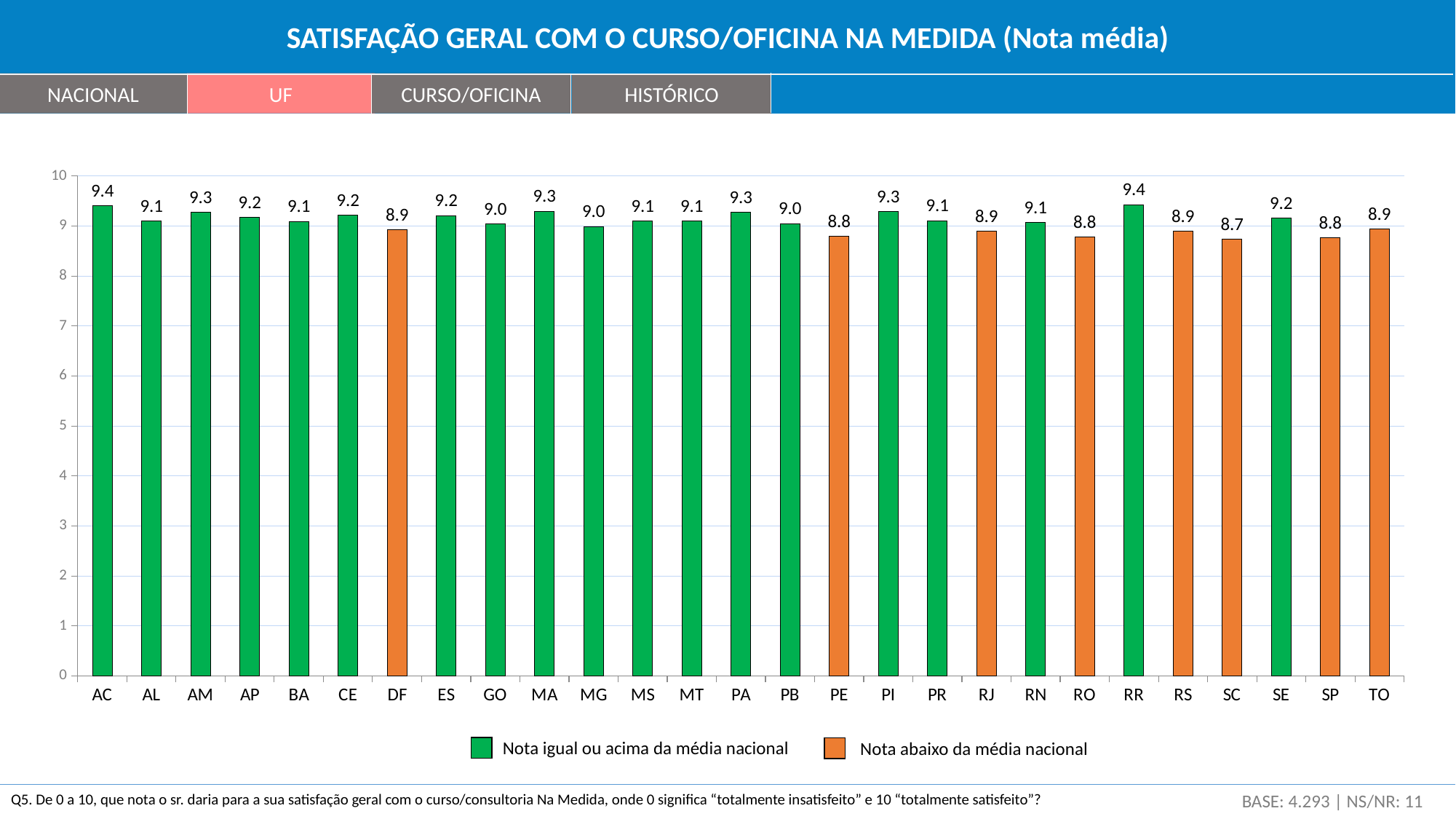
How many states are shown on the x axis? 27 Which state has the lowest value? SC What is the difference between the values for RR and SC? 0.7 Which has a larger value, AM or RJ? AM What kind of chart is shown? bar chart What is the value for AC? 9.4 What is the value for MA? 9.3 How many bars are coloured orange (Nota abaixo da média nacional)? 8 What is the value for PE? 8.8 Is the value for DF greater or less than 9? less What is the value for SC? 8.7 How many entries does the legend list? 2